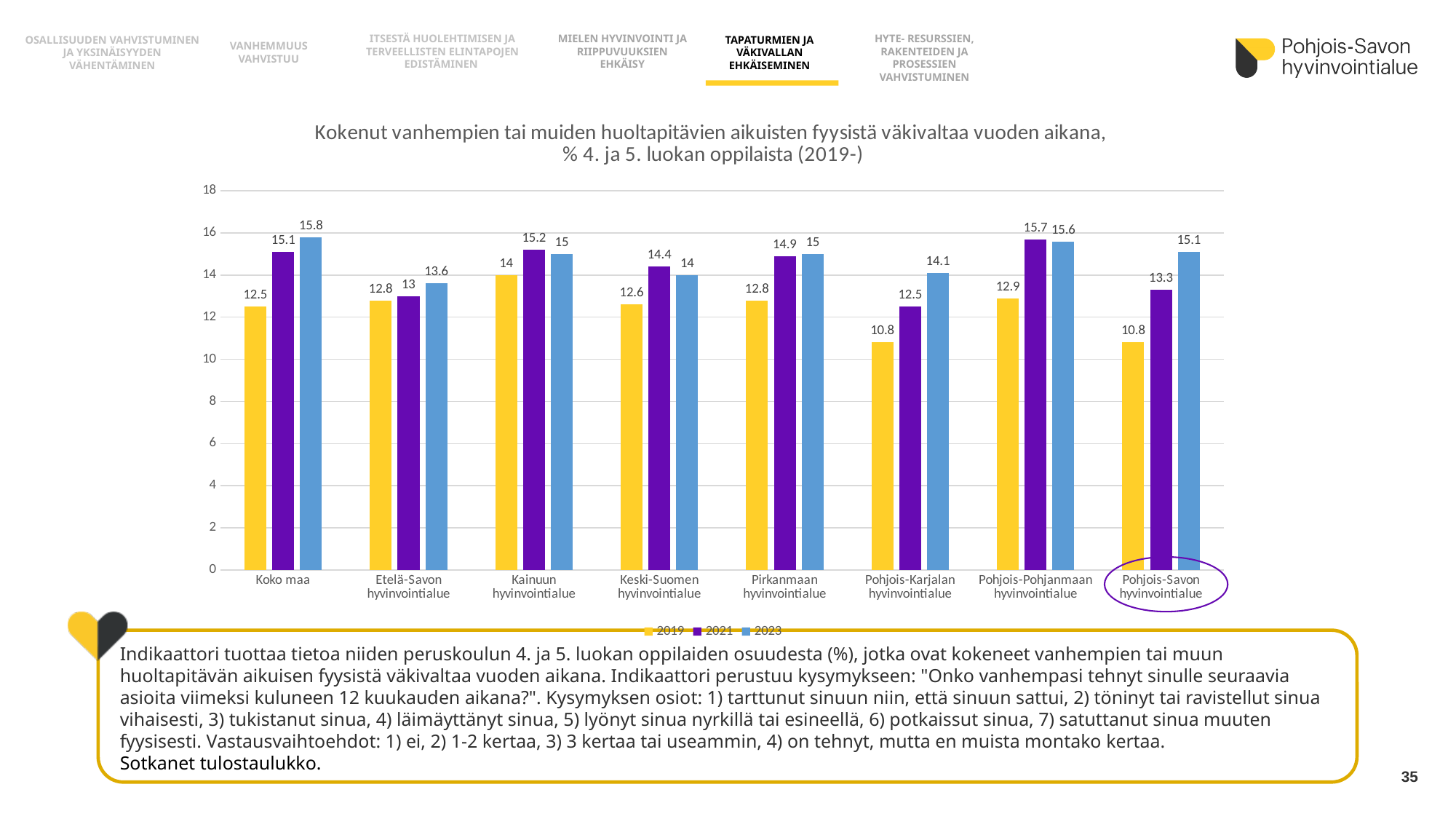
How many categories are shown on the x axis? 8 Which category has the lowest 2021 value? Pohjois-Karjalan hyvinvointialue What is the 2019 value for Koko maa? 12.5 What is the difference between the 2023 and 2019 values for Pohjois-Savon hyvinvointialue? 4.3 Do the values for Pohjois-Karjalan hyvinvointialue rise or fall from 2019 to 2023? Rise How many series does the legend list? 3 Which is larger for Kainuun hyvinvointialue, the 2021 value or the 2023 value? 2021 Which category on the x axis is circled? Pohjois-Savon hyvinvointialue What is the 2021 value for Pohjois-Pohjanmaan hyvinvointialue? 15.7 What is the 2023 value for Pohjois-Savon hyvinvointialue? 15.1 Which category has the highest 2023 value? Koko maa What kind of chart is shown on the slide? Bar chart